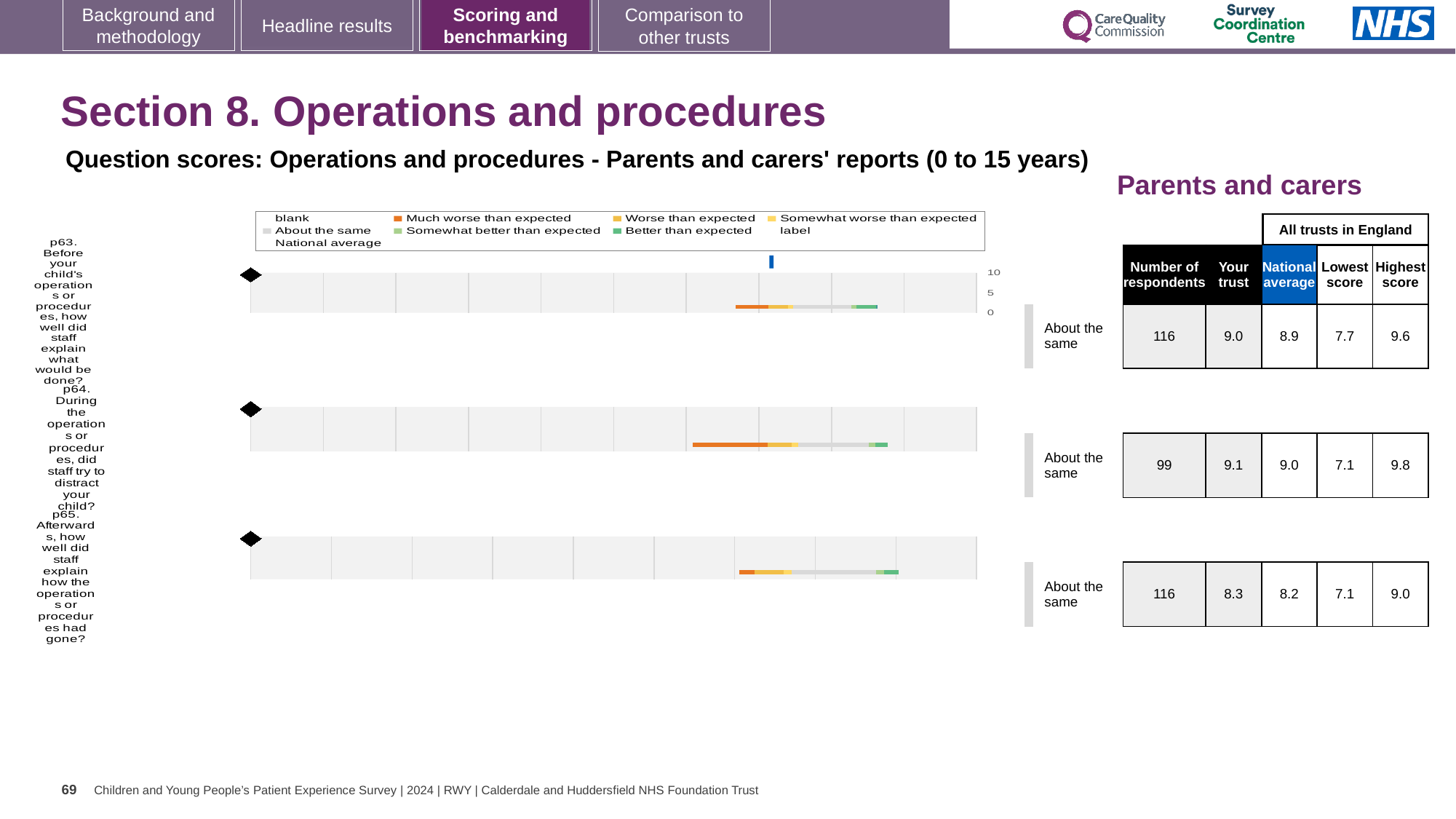
What benchmarking category is the trust's result in for p64? About the same What is the highest score among all trusts in England for p64? 9.8 What is the lowest score among all trusts in England for p63? 7.7 What is the national average score for p64 (During the operations or procedures, did staff try to distract your child?)? 9.0 Which question has the highest 'Your trust' score? p64 Which has the larger 'Your trust' score, p63 or p65? p63 What is the difference between the 'Your trust' score and the national average for p65? 0.1 What is the difference between the highest and lowest trust scores for p64? 2.7 What is the 'Your trust' score for p63 (Before your child's operations or procedures, how well did staff explain what would be done?)? 9.0 Which question has the lowest 'Your trust' score? p65 How many questions are plotted on this slide? 3 How many respondents answered p65 (Afterwards, how well did staff explain how the operations or procedures had gone?)? 116